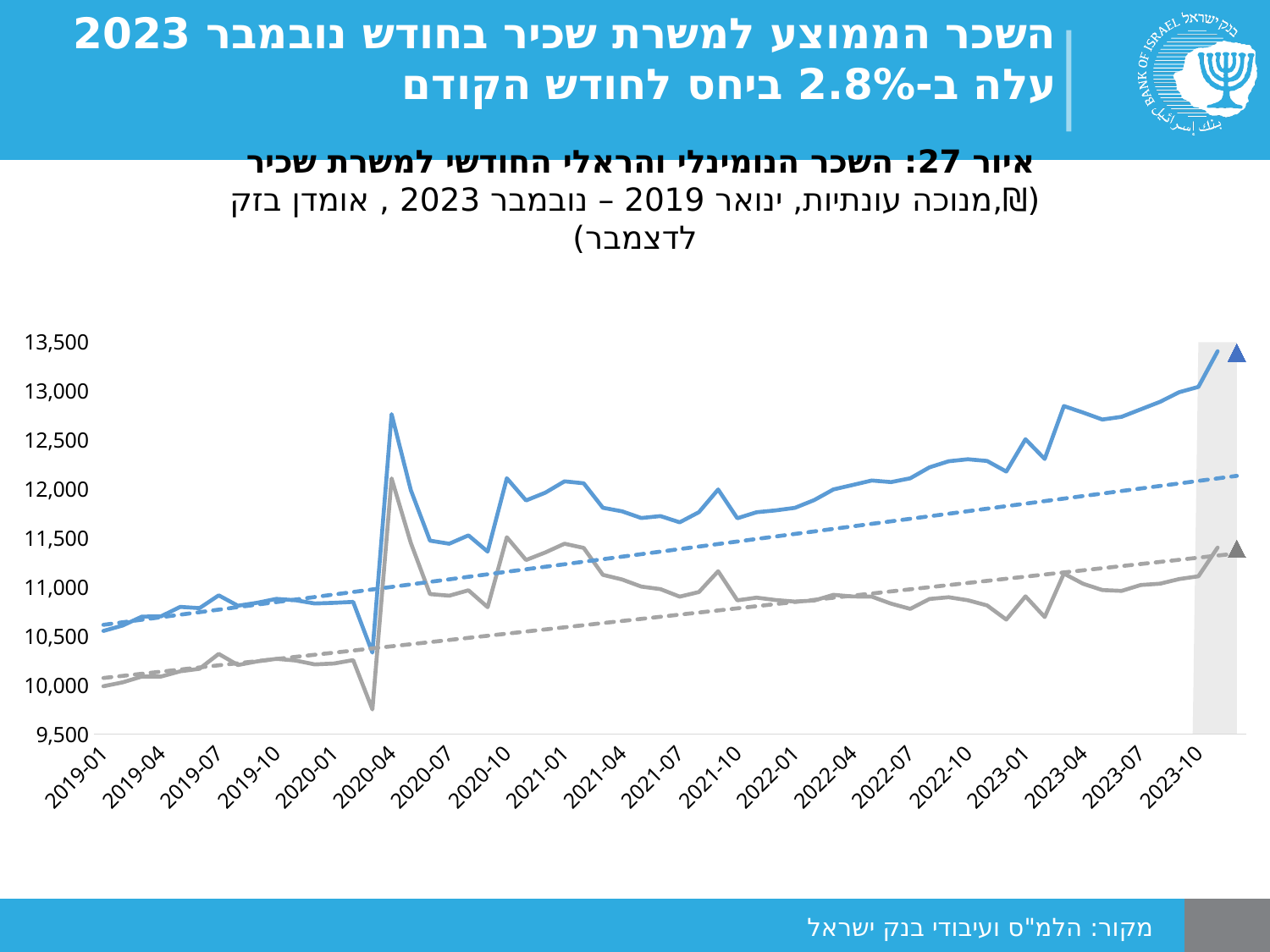
What is the highest value shown on the y axis? 13,500 Which solid line is higher throughout the chart, the blue one or the gray one? the blue one At which point does the gray solid line reach its highest value? 2020-04 Is the final value of the blue solid line (late 2023) greater or less than 13,000? greater How many date labels are shown along the x axis? 20 Is the value of the blue solid line at 2022-01 greater or less than 12,000? less Do the solid lines generally rise or fall from 2019-01 to the end of the series? rise What is the first date label on the x axis? 2019-01 Is the final value of the gray solid line (late 2023) greater or less than 11,500? less What kind of chart is shown on the slide? line chart